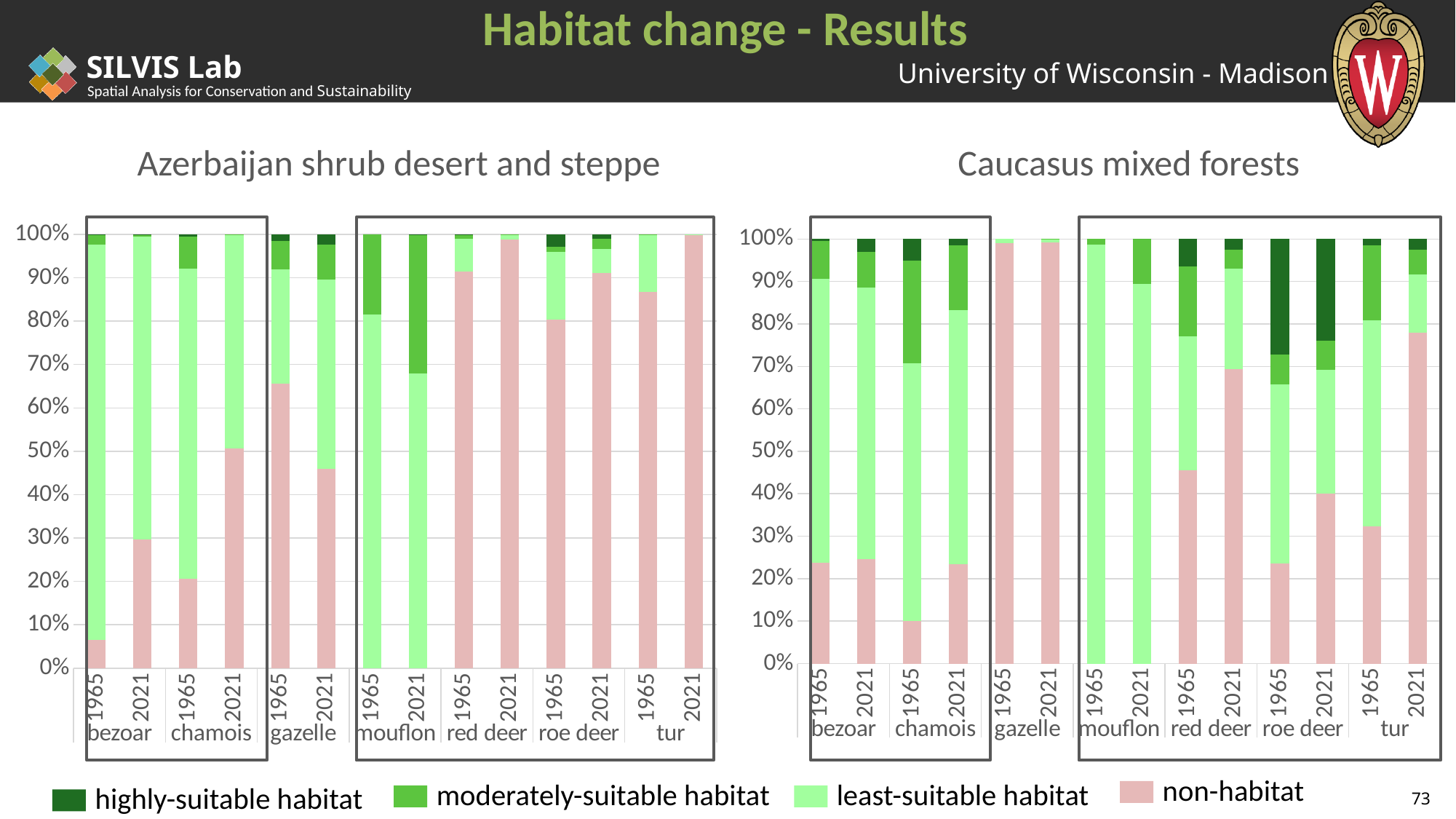
In the Azerbaijan shrub desert and steppe chart, which is larger for bezoar: the non-habitat share in 1965 or in 2021? 2021 In the Azerbaijan shrub desert and steppe chart, which species has the smallest non-habitat share in 1965? mouflon What kind of chart is used on this slide? stacked bar chart In the Azerbaijan shrub desert and steppe chart, is the non-habitat share for bezoar in 1965 greater or less than 10%? less In the Azerbaijan shrub desert and steppe chart, how many species are shown on the x axis? 7 In the Azerbaijan shrub desert and steppe chart, is the non-habitat share for gazelle in 1965 greater or less than 60%? greater In the Caucasus mixed forests chart, is the non-habitat share for red deer in 1965 greater or less than 50%? less In the Caucasus mixed forests chart, how many bars are plotted in total? 14 How many series does the legend list? 4 Which legend entry is shown in the darkest green? highly-suitable habitat In the Caucasus mixed forests chart, which is larger for roe deer: the non-habitat share in 1965 or in 2021? 2021